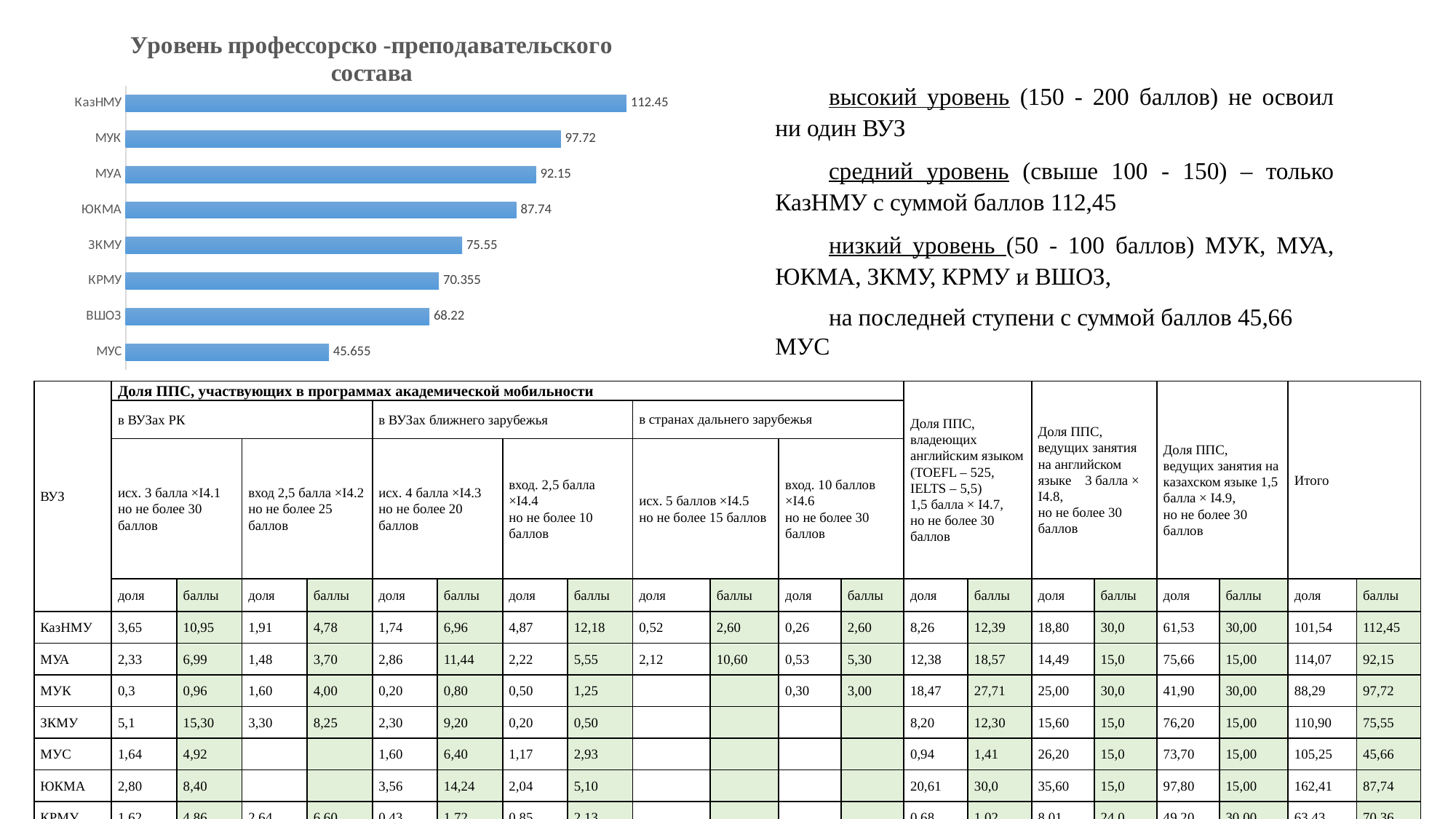
What is the difference between the values for КазНМУ and МУК? 14.73 What is the value for МУС in the chart? 45.655 Which category has the highest value in the chart? КазНМУ Which has a larger value, МУА or ЮКМА? МУА What is the difference between the values for ВШОЗ and МУС? 22.565 What type of chart is shown on the slide? Bar chart What is the value for КРМУ in the chart? 70.355 What is the title of the chart? Уровень профессорско -преподавательского состава Which category has the lowest value in the chart? МУС How many categories are shown in the chart? 8 What is the value for КазНМУ in the chart? 112.45 What is the value for ЗКМУ in the chart? 75.55